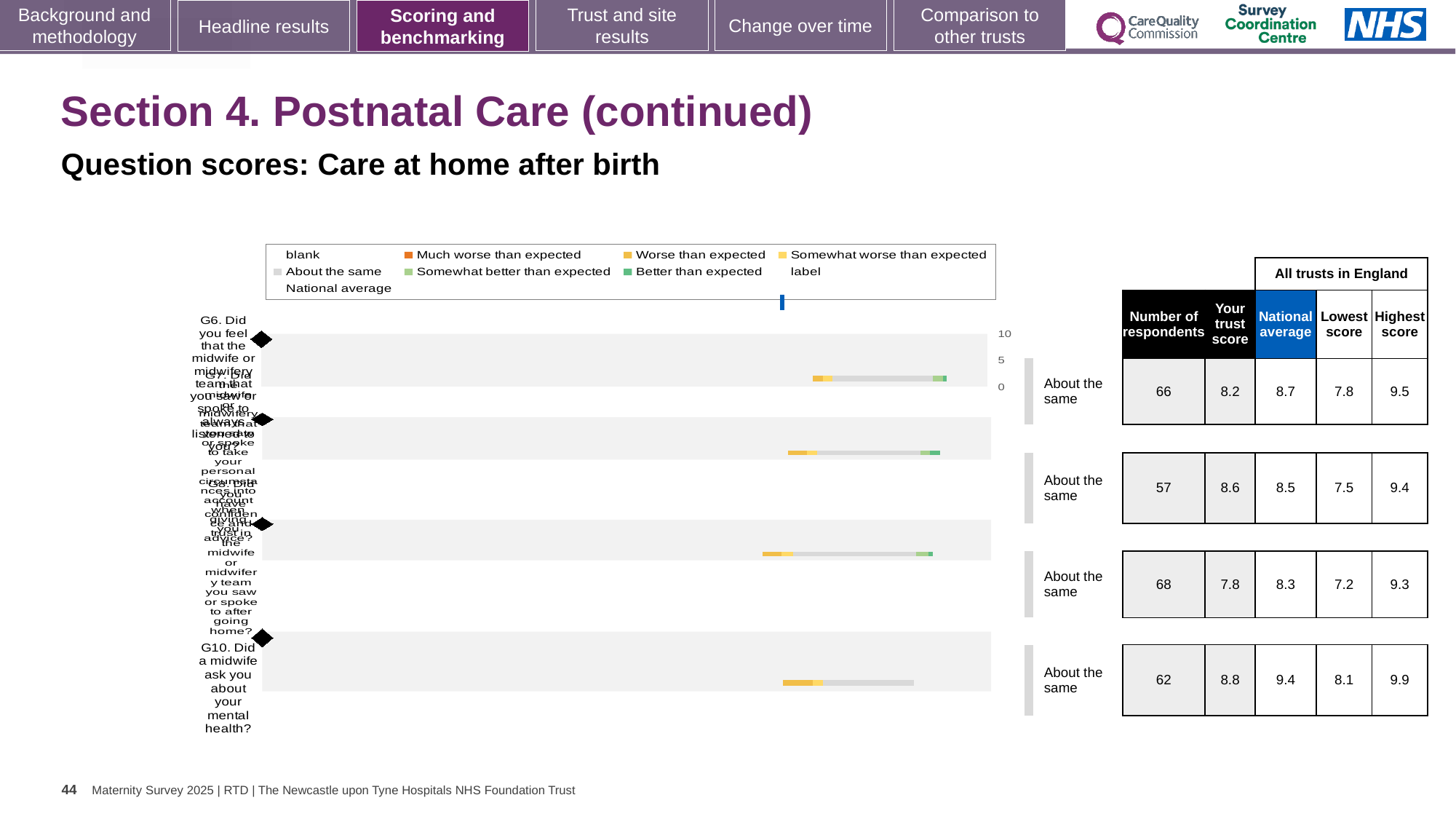
In the table beside the chart, which row has the highest 'Highest score' value? the bottom row (G10), 9.9 In the table beside the chart, is the trust score in the bottom row (8.8) larger or smaller than the national average (9.4)? smaller In the table beside the chart, what is the number of respondents in the top row (G6)? 66 What is the subtitle describing the chart's content? Question scores: Care at home after birth What kind of chart is shown on the slide? bar chart In the table beside the chart, what is the trust score in the row for G10 (the bottom row)? 8.8 What benchmark category is shown to the right of every bar in the chart? About the same In the table beside the chart, what is the difference between the national average and the trust score in the top row (G6)? 0.5 How many question bars are plotted in the chart? 4 What colour does the legend use for 'Much worse than expected'? orange What colour does the legend use for 'Better than expected'? green What is the label of the last (bottom) question bar in the chart? G10. Did a midwife ask you about your mental health?